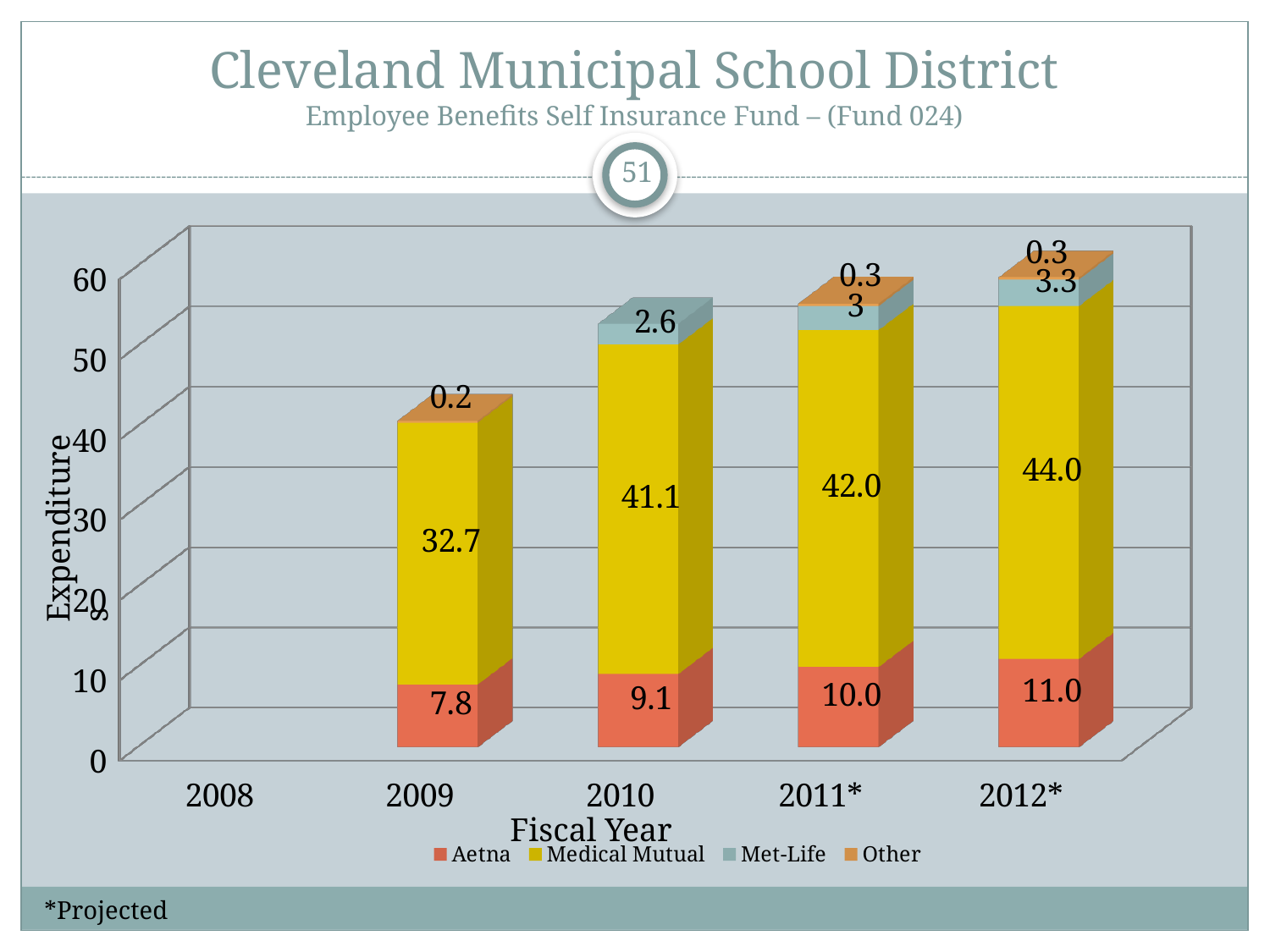
What kind of chart is shown on the slide? Stacked bar chart How much higher is the Medical Mutual expenditure in 2012* than in 2009? 11.3 What is the Other expenditure for fiscal year 2009? 0.2 What is the Aetna expenditure for fiscal year 2012*? 11.0 Which fiscal year has the larger Aetna expenditure, 2010 or 2011*? 2011* Which fiscal year has the highest Medical Mutual expenditure? 2012* How many series does the legend list? 4 Does the Aetna expenditure rise or fall from 2009 to 2012*? Rise What is the total expenditure for fiscal year 2012* across all four series? 58.6 Which fiscal year has the lowest Aetna expenditure? 2009 What is the Met-Life expenditure for fiscal year 2011*? 3 What is the Medical Mutual expenditure for fiscal year 2010? 41.1